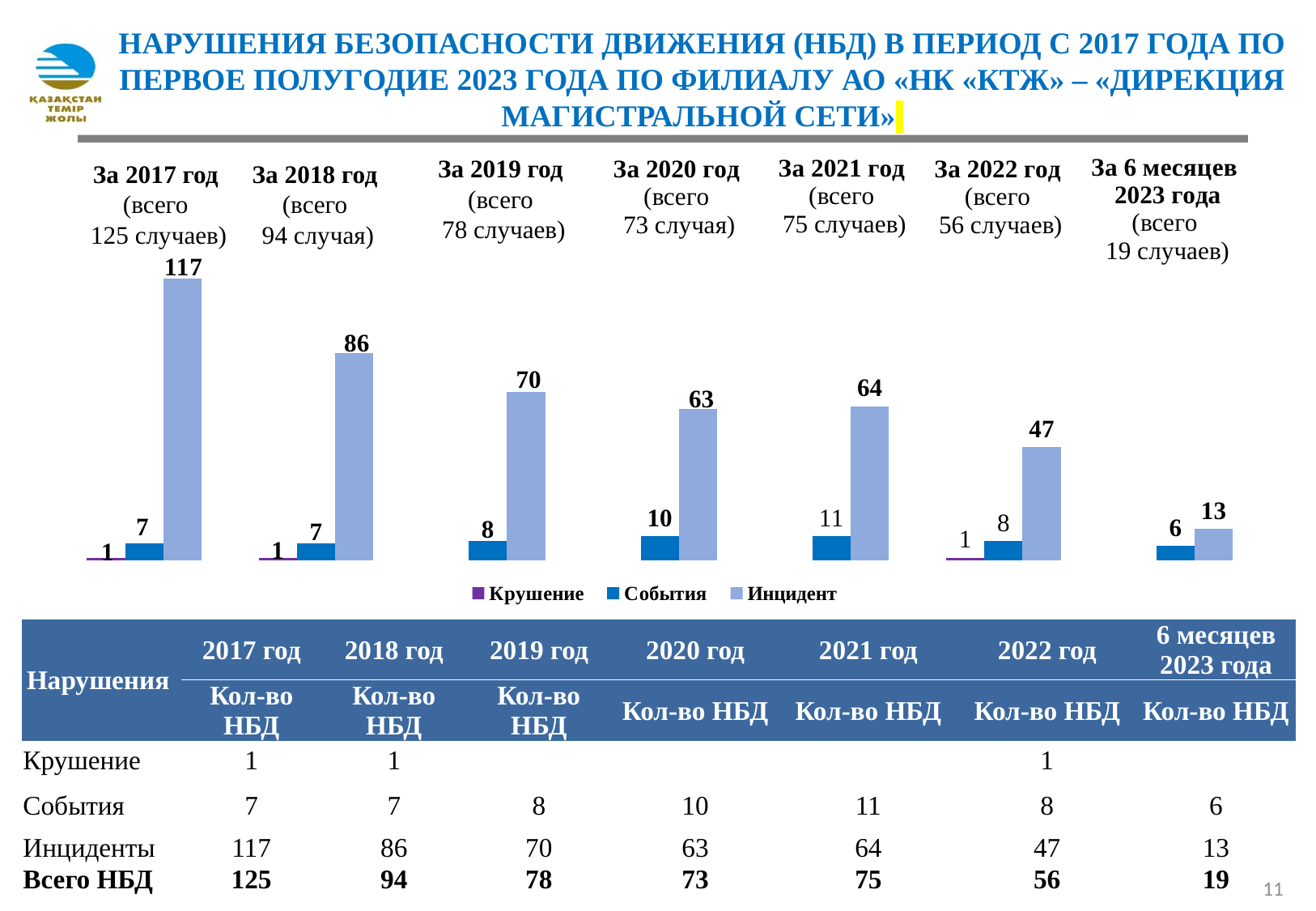
What kind of chart is shown on the slide? bar chart How many periods (category groups) are shown on the chart? 7 Which is larger, the Инцидент value for За 2020 год or for За 2021 год? За 2021 год What is the value of the События series for За 2021 год? 11 What is the value of the Крушение series for За 2022 год? 1 What is the value of the Инцидент series for За 2017 год? 117 Which period has the highest value for the Инцидент series? За 2017 год What are the three series named in the chart legend? Крушение, События, Инцидент Which period has the lowest value for the Инцидент series? За 6 месяцев 2023 года What is the difference between the Инцидент values for За 2017 год and За 2018 год? 31 Does the Инцидент series rise or fall from За 2017 год to За 6 месяцев 2023 года? fall How many series does the legend list? 3